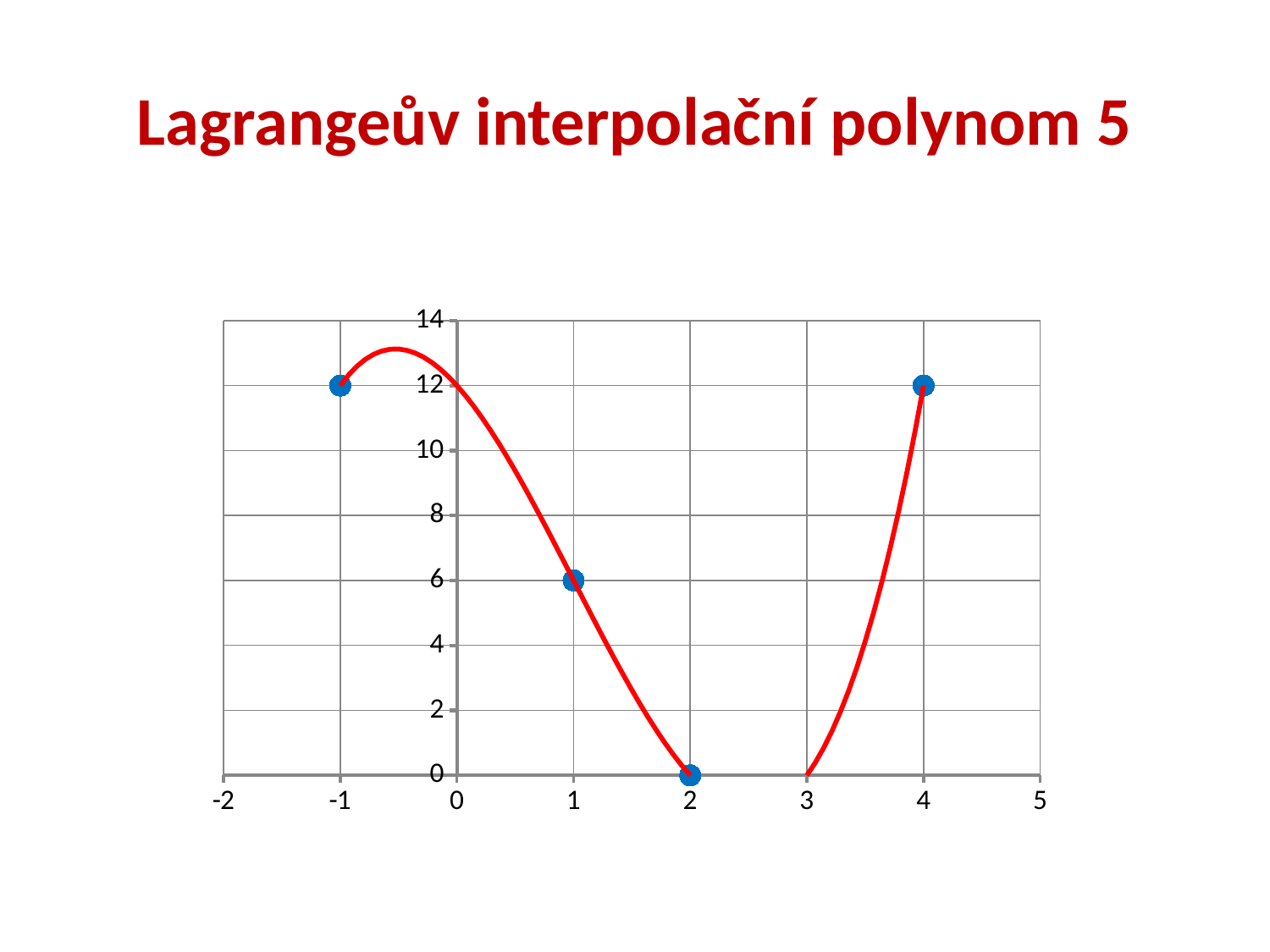
What is the highest value shown on the vertical axis? 14 What is the y value of the plotted point at x = 2? 0 What is the y value of the plotted point at x = -1? 12 How many data points are marked on the chart? 4 What is the y value of the plotted point at x = 1? 6 At which x value does the marked point have the lowest y value? 2 Do the marked points rise or fall in y value from x = -1 to x = 2? fall Is the value of the red curve at x = -0.5 greater or less than 12? greater What is the difference between the y values of the points at x = 1 and x = 2? 6 What is the title of the slide containing the chart? Lagrangeův interpolační polynom 5 Which marked point has the larger y value, the one at x = 1 or the one at x = 4? x = 4 What is the y value of the plotted point at x = 4? 12